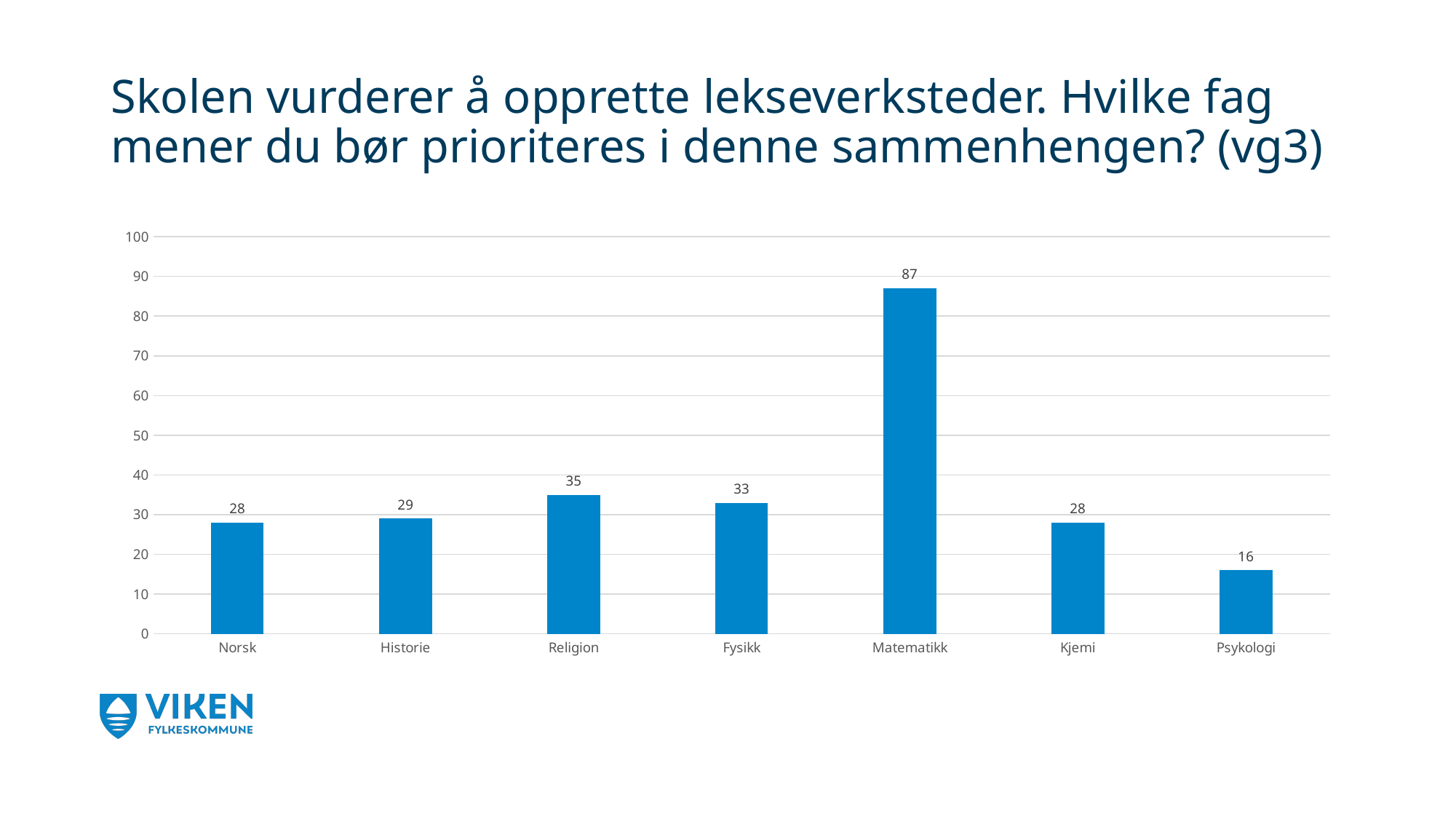
What kind of chart is shown on the slide? Bar chart Which category has the highest value? Matematikk What is the value for Matematikk? 87 What is the value for Religion? 35 What is the value for Fysikk? 33 What is the difference between the values for Matematikk and Religion? 52 Which category has the lowest value? Psykologi Is the value for Matematikk greater or less than 80? greater What is the difference between the values for Historie and Psykologi? 13 What is the value for Psykologi? 16 Which is larger, the value for Religion or the value for Fysikk? Religion How many categories are shown on the x axis? 7